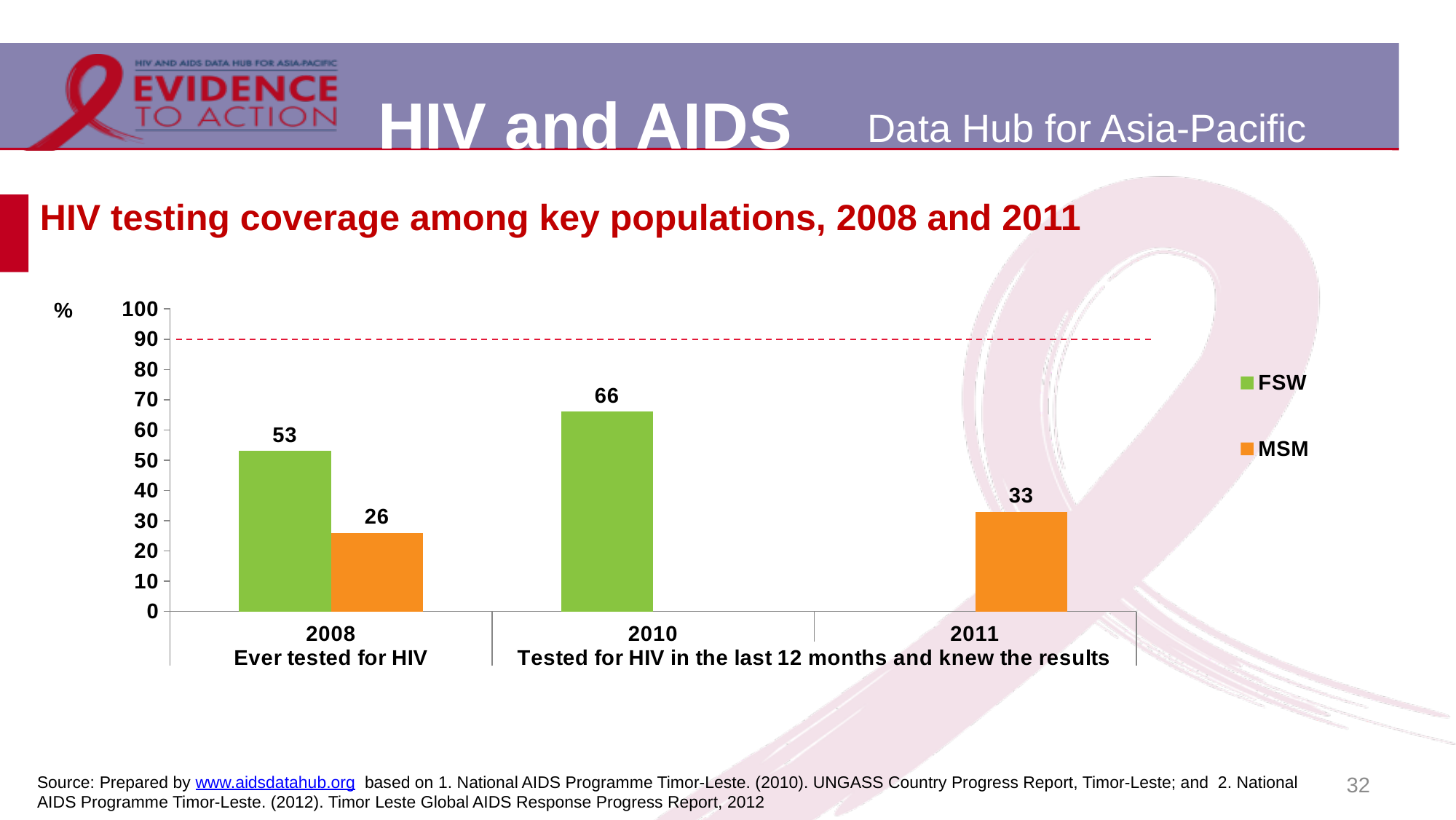
What is the value for MSM in 2011 (Tested for HIV in the last 12 months and knew the results)? 33 What is the value for MSM in 2008 (Ever tested for HIV)? 26 What is the value for FSW in 2010 (Tested for HIV in the last 12 months and knew the results)? 66 Which is larger: the FSW value in 2010 or the MSM value in 2011? FSW value in 2010 At what level is the dashed horizontal line drawn on the chart? 90 Which bar has the highest value on the chart? FSW in 2010 How many series does the legend list? 2 What is the value for FSW in 2008 (Ever tested for HIV)? 53 Which bar has the lowest value on the chart? MSM in 2008 What kind of chart is shown on the slide? Bar chart What is the difference between the FSW and MSM values in 2008? 27 Is the value for MSM in 2011 greater or less than 40? less